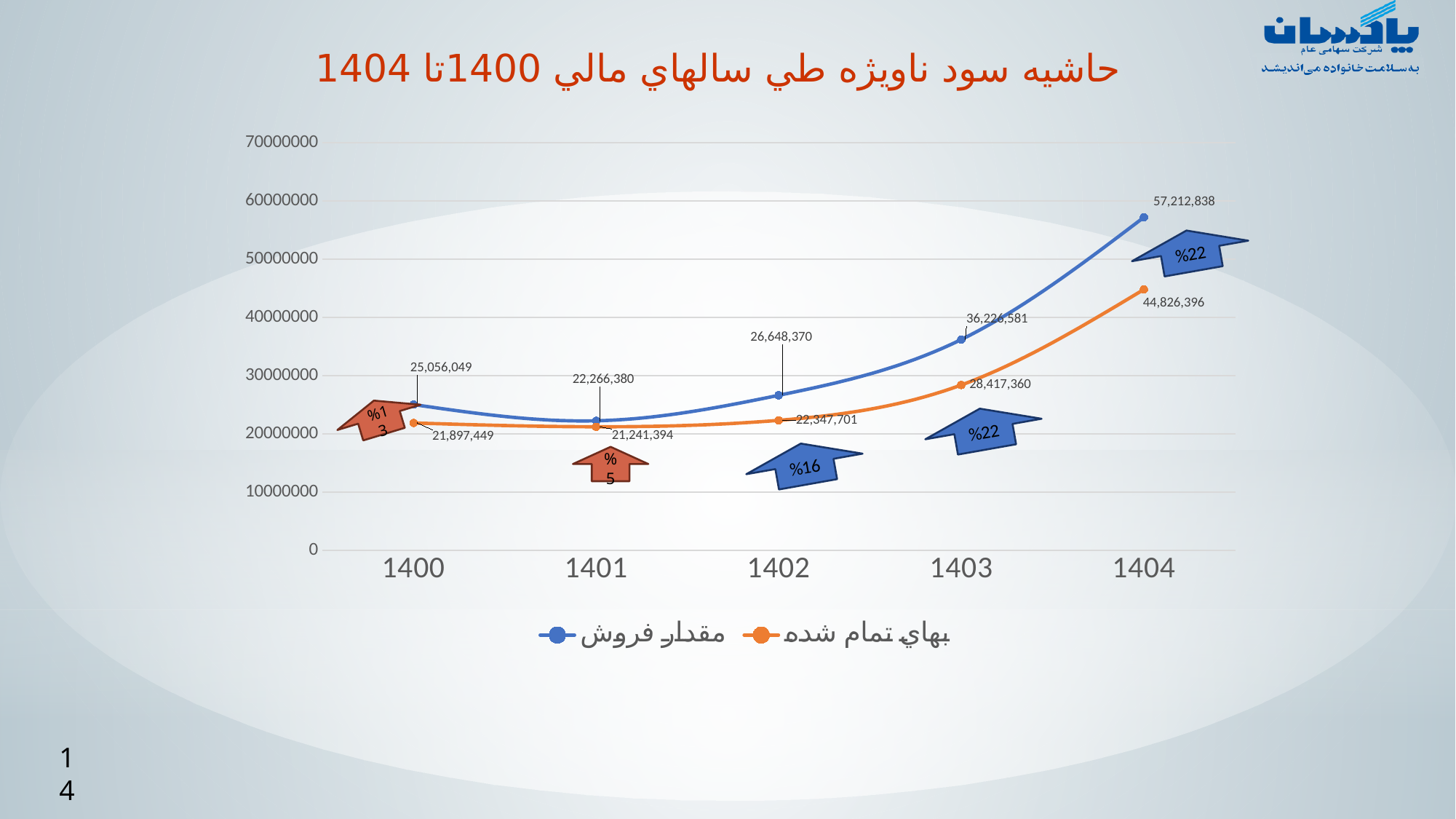
In which year is مقدار فروش highest? 1404 What is the value of مقدار فروش in 1401? 22,266,380 What is the value of مقدار فروش in 1404? 57,212,838 How many series does the legend list? 2 Which series is drawn in orange? بهاي تمام شده In which year is بهاي تمام شده lowest? 1401 What is the value of بهاي تمام شده in 1403? 28,417,360 Which is larger in 1402: مقدار فروش or بهاي تمام شده? مقدار فروش How many years are plotted along the x axis? 5 What is the difference between مقدار فروش and بهاي تمام شده in 1404? 12,386,442 What type of chart is shown on the slide? line chart Is the value of مقدار فروش in 1403 greater or less than 30000000? greater